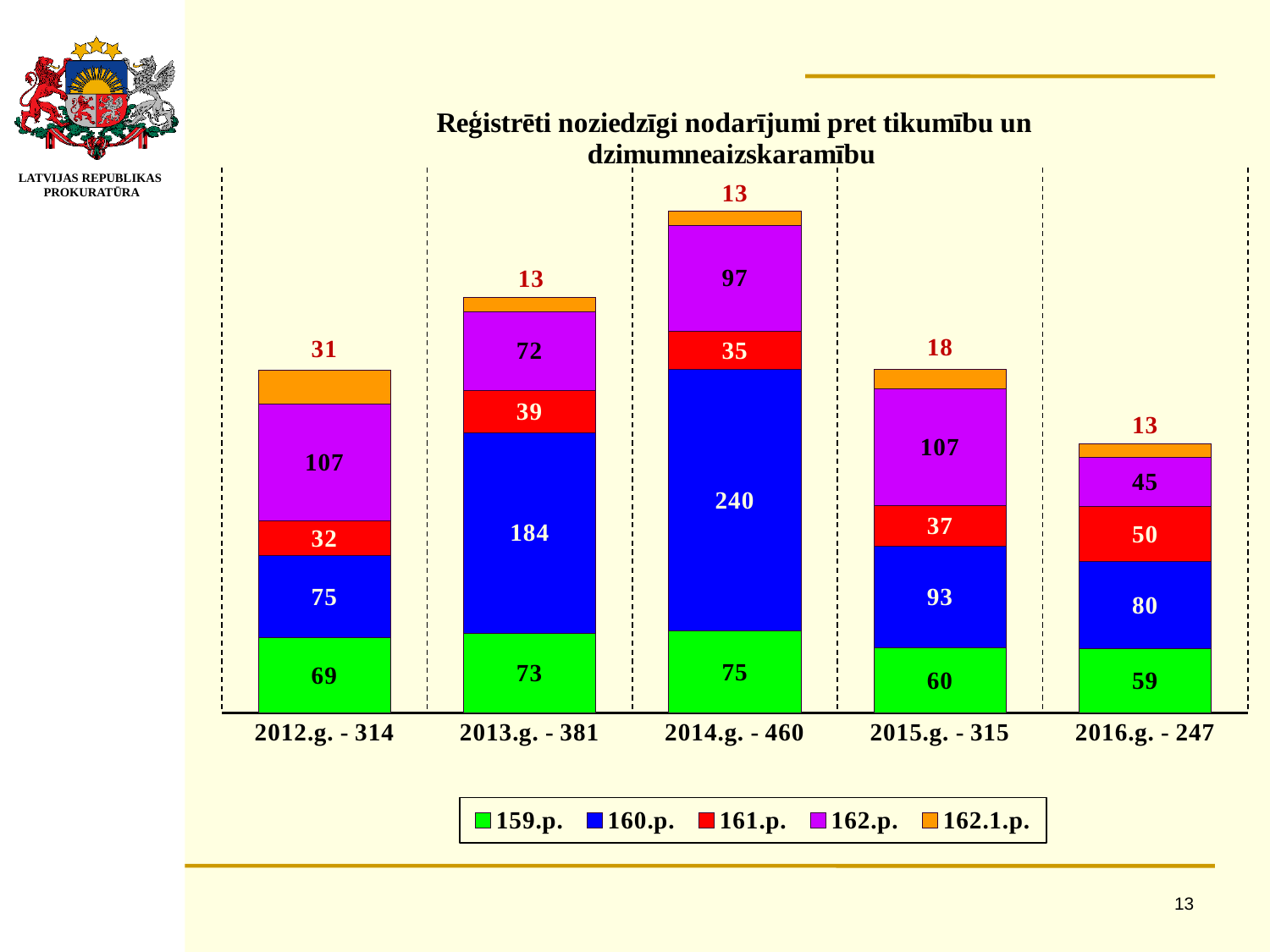
What is the total of the stacked bar for 2014? 460 How many years are shown on the x axis? 5 Which is larger, the 161.p. value for 2013 or for 2015? 2013 How many series does the legend list? 5 What is the value for 162.p. in 2015? 107 What kind of chart is shown on the slide? Stacked bar chart Which year has the lowest value for 162.p.? 2016 What is the value for 161.p. in 2016? 50 What is the value for 162.1.p. in 2012? 31 What is the difference between the 160.p. values for 2013 and 2012? 109 Which year has the highest value for 159.p.? 2014 What is the value for 160.p. in 2014? 240